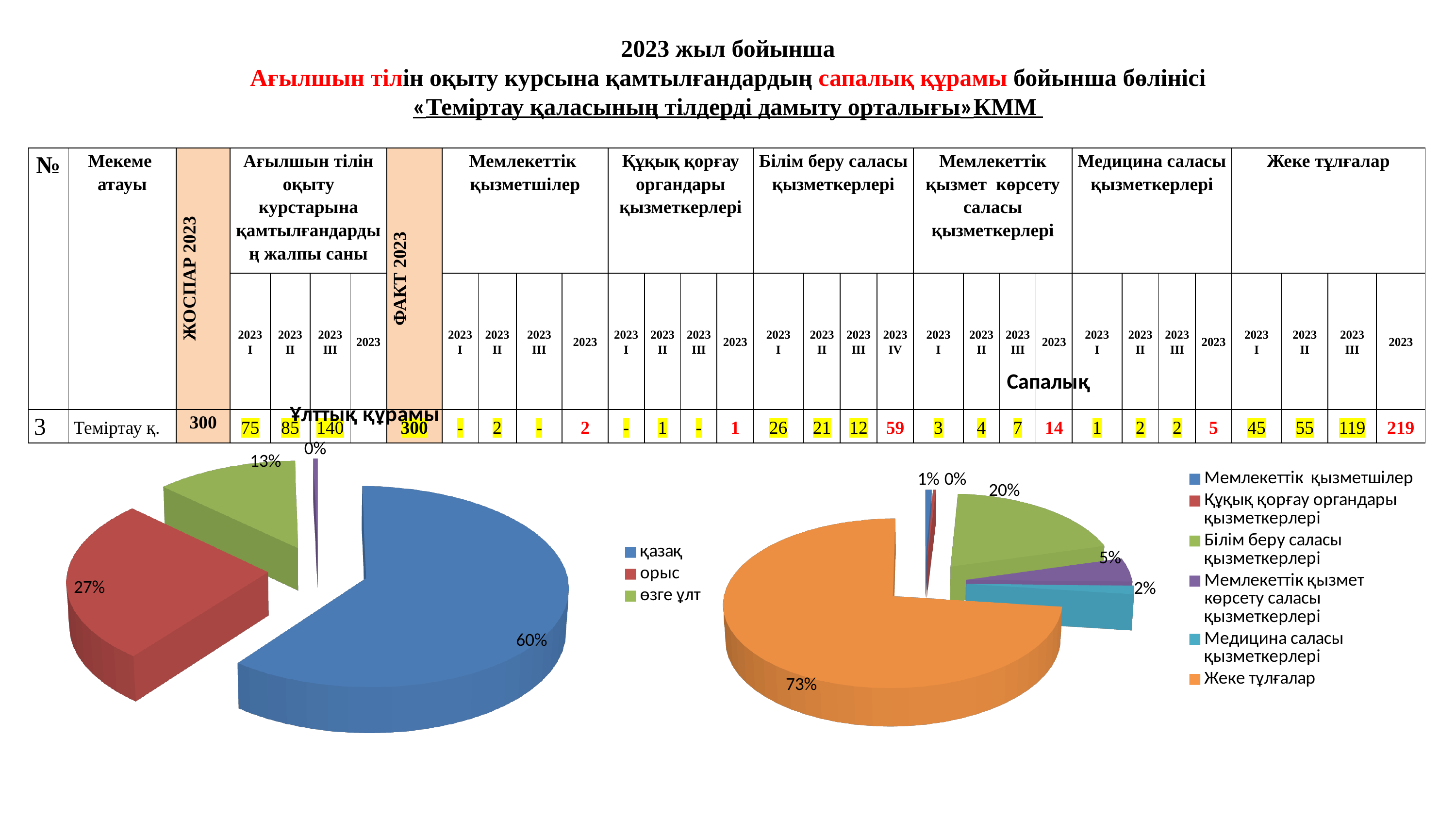
How many entries does the legend of the right pie chart "Сапалық" list? 6 In the right pie chart "Сапалық", which category has the largest slice? Жеке тұлғалар In the left pie chart "Ұлттық құрамы", what share does өзге ұлт have? 13% In the left pie chart "Ұлттық құрамы", what share does орыс have? 27% In the right pie chart "Сапалық", what share does Жеке тұлғалар have? 73% In the left pie chart "Ұлттық құрамы", which category has the largest slice? қазақ What kind of chart is the left chart titled "Ұлттық құрамы"? pie chart In the left pie chart "Ұлттық құрамы", what is the difference between the қазақ and орыс shares? 33% In the left pie chart "Ұлттық құрамы", what share does қазақ have? 60% In the right pie chart "Сапалық", what share does Білім беру саласы қызметкерлері have? 20% How many entries does the legend of the left pie chart "Ұлттық құрамы" list? 3 In the right pie chart "Сапалық", what share does Мемлекеттік қызмет көрсету саласы қызметкерлері have? 5%